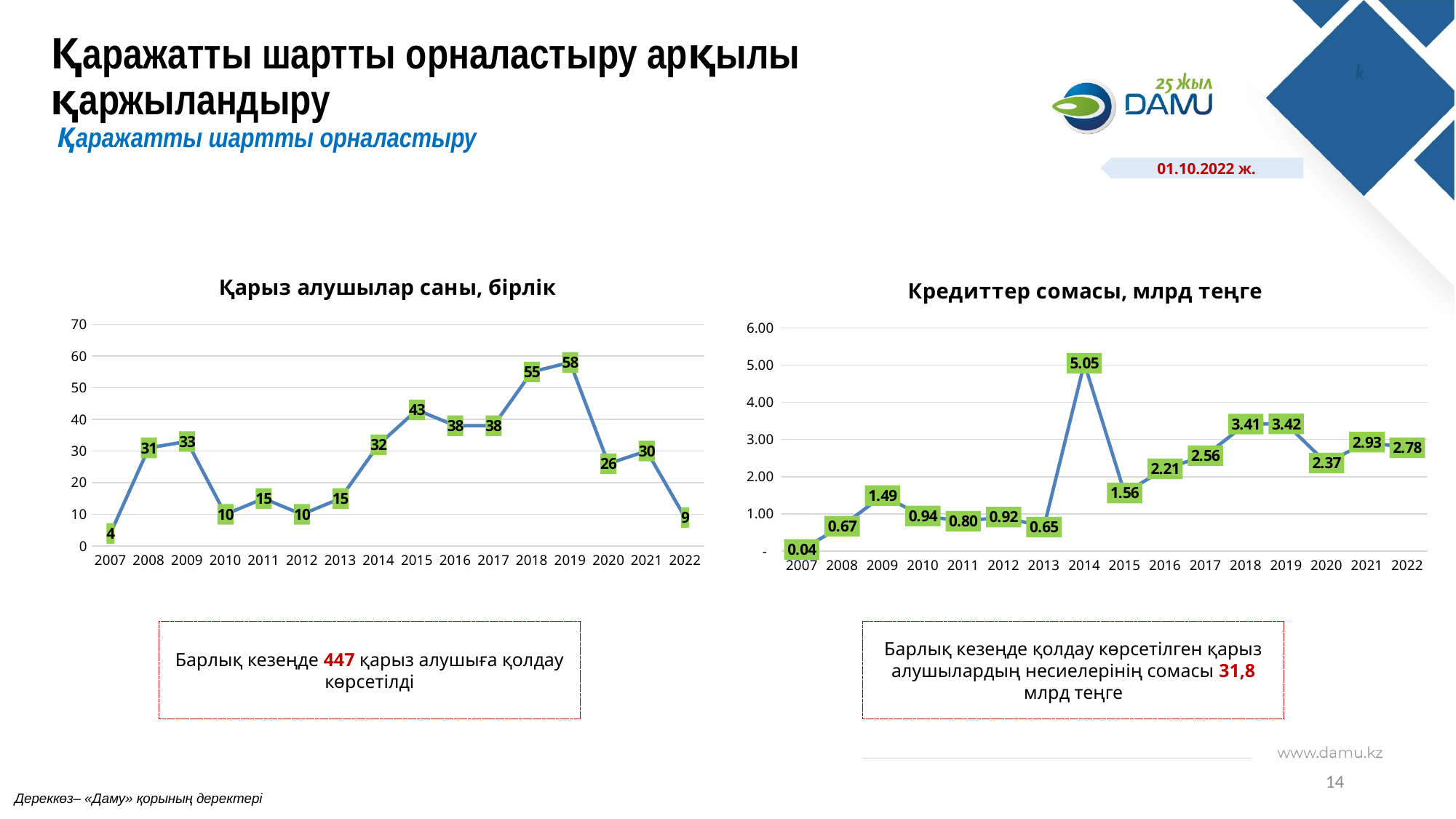
What is the title of the chart on the right side of the slide? Кредиттер сомасы, млрд теңге In the chart titled "Кредиттер сомасы, млрд теңге", which year has the highest value? 2014 In the chart titled "Кредиттер сомасы, млрд теңге", what is the value for 2014? 5.05 In the chart titled "Қарыз алушылар саны, бірлік", what is the difference between the values for 2018 and 2020? 29 In the chart titled "Қарыз алушылар саны, бірлік", which year has the lowest value? 2007 In the chart titled "Кредиттер сомасы, млрд теңге", what is the value for 2007? 0.04 In the chart titled "Кредиттер сомасы, млрд теңге", do the values rise or fall from 2015 to 2018? rise In the chart titled "Кредиттер сомасы, млрд теңге", which is larger, the value for 2021 or the value for 2022? 2021 In the chart titled "Қарыз алушылар саны, бірлік", is the value for 2009 greater or less than 30? greater In the chart titled "Қарыз алушылар саны, бірлік", how many years are plotted on the x axis? 16 What kind of chart is the chart titled "Қарыз алушылар саны, бірлік"? line chart In the chart titled "Қарыз алушылар саны, бірлік", what is the value for 2019? 58